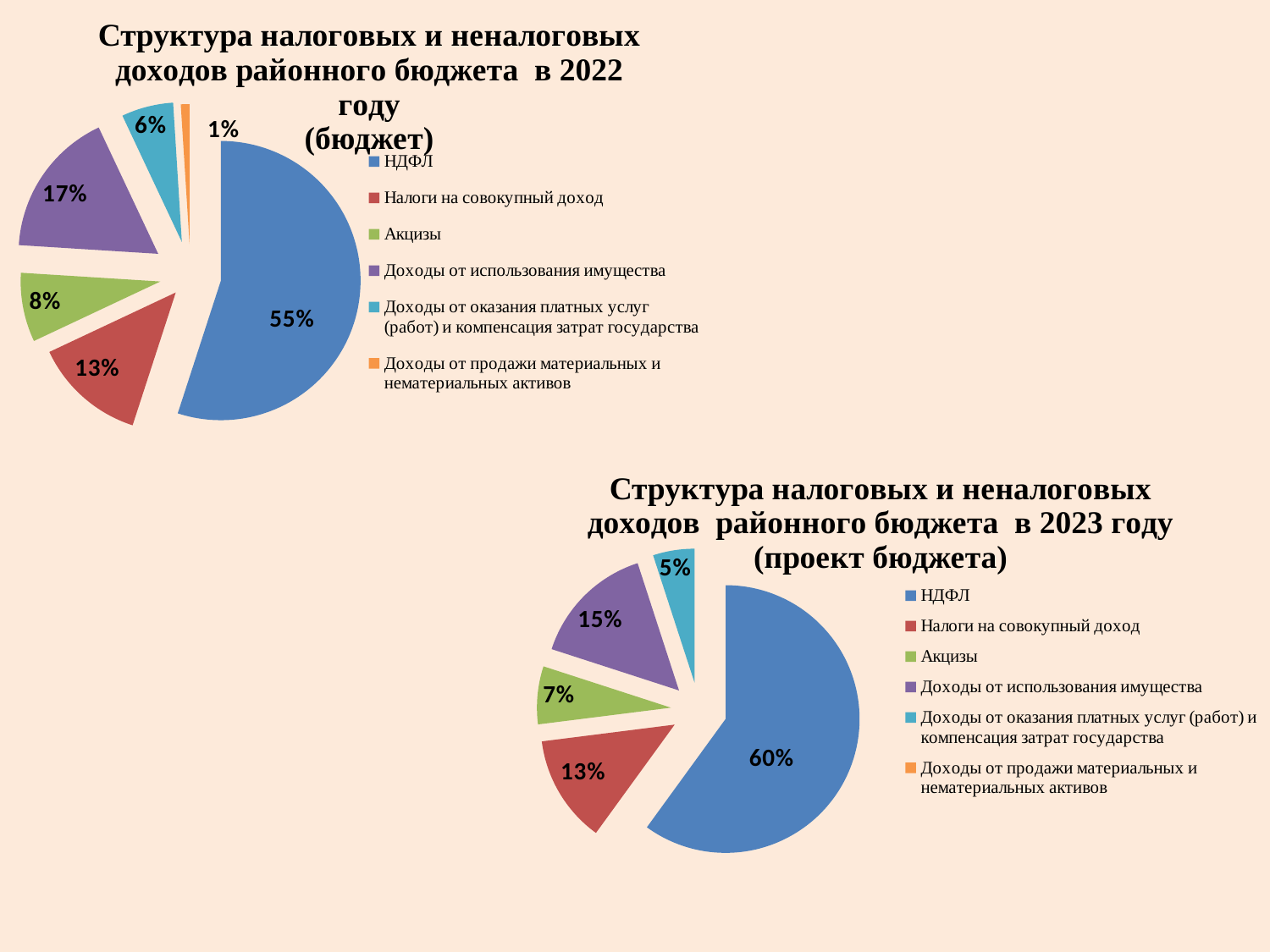
In the 2023 chart (bottom), what share does Акцизы have? 7% What type of chart is the 2022 chart (top)? Pie chart In the 2022 chart (top), which category has the smallest share? Доходы от продажи материальных и нематериальных активов In the 2022 chart (top), what share does НДФЛ have? 55% Which is larger in the 2022 chart (top): the share of Налоги на совокупный доход or the share of Доходы от оказания платных услуг (работ) и компенсация затрат государства? Налоги на совокупный доход How many entries does the legend of the 2023 chart (bottom) list? 6 In the 2022 chart (top), what share does Доходы от оказания платных услуг (работ) и компенсация затрат государства have? 6% In the 2023 chart (bottom), what share does НДФЛ have? 60% What colour represents НДФЛ in the 2023 chart (bottom)? Blue In the 2023 chart (bottom), which category has the largest share? НДФЛ In the 2022 chart (top), what is the difference between the shares of Доходы от использования имущества and Акцизы? 9% In the 2022 chart (top), what share does Доходы от использования имущества have? 17%